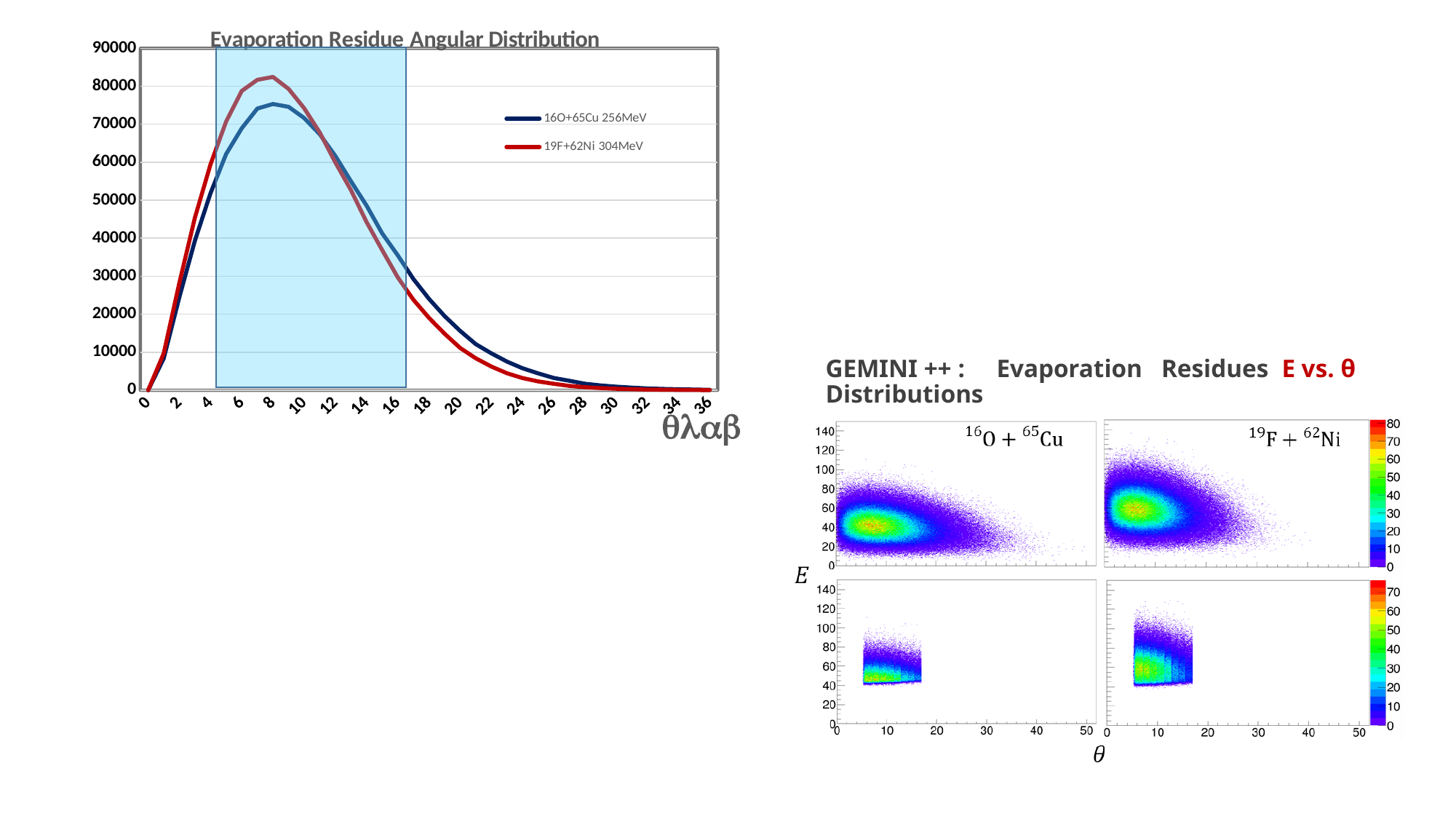
What is the highest tick value shown on the y axis of the 'Evaporation Residue Angular Distribution' chart? 90000 In the 'Evaporation Residue Angular Distribution' chart, is the peak value of the 19F+62Ni 304MeV series greater or less than 80000? greater In the 'Evaporation Residue Angular Distribution' chart, is the value of the 19F+62Ni 304MeV series at x = 20 greater or less than 20000? less What kind of chart is the 'Evaporation Residue Angular Distribution' chart? line chart In the 'Evaporation Residue Angular Distribution' chart, is the value of the 16O+65Cu 256MeV series at x = 14 greater or less than 40000? greater In the 'Evaporation Residue Angular Distribution' chart, which series is drawn in red? 19F+62Ni 304MeV In the 'Evaporation Residue Angular Distribution' chart, which series has the larger value at x = 20? 16O+65Cu 256MeV How many series does the legend of the 'Evaporation Residue Angular Distribution' chart list? 2 In the 'Evaporation Residue Angular Distribution' chart, which series reaches the higher peak value? 19F+62Ni 304MeV In the 'Evaporation Residue Angular Distribution' chart, do the values rise or fall along the x axis from x = 8 to x = 36? fall